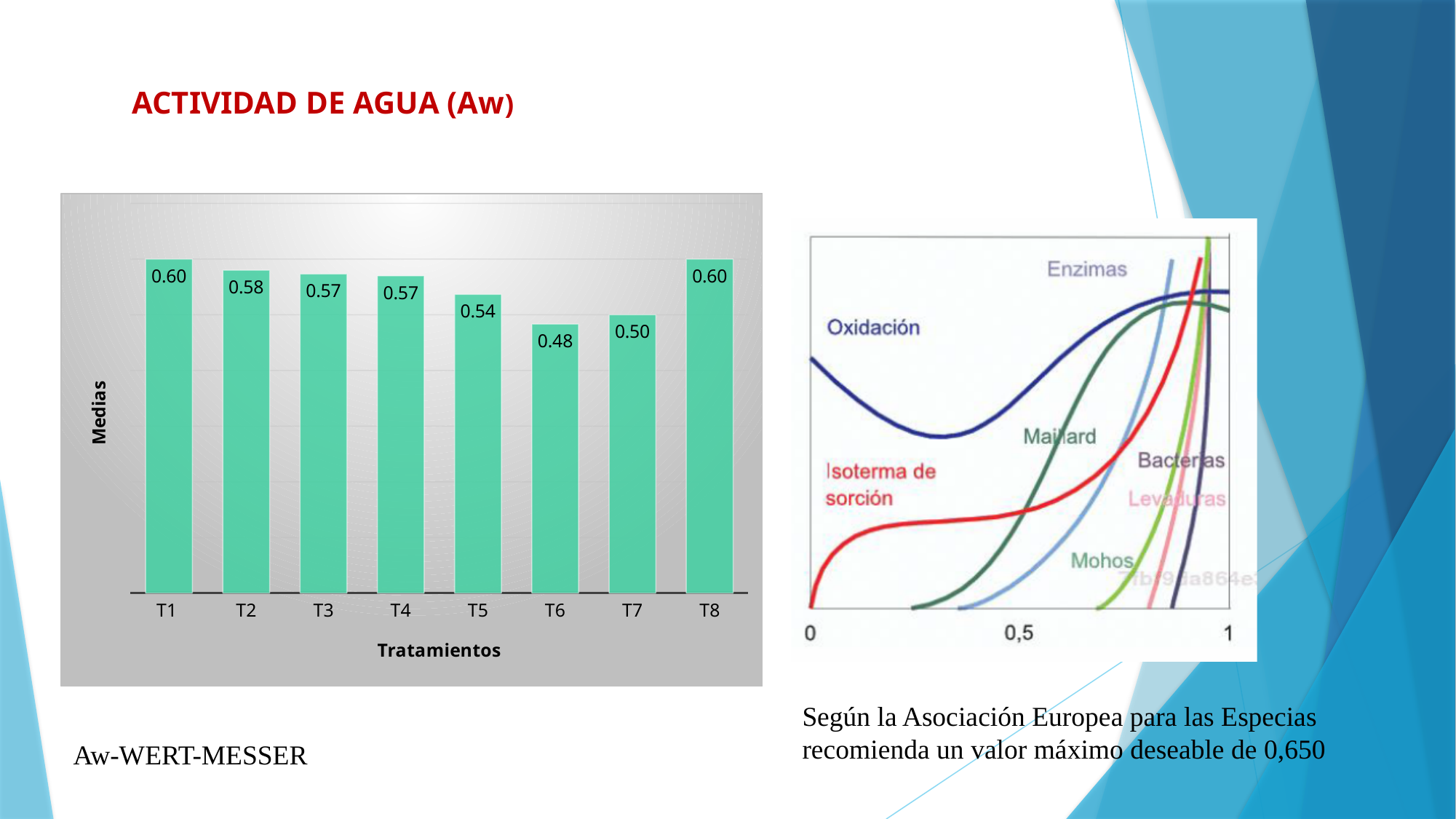
In the bar chart on the left, what is the value for T1? 0.60 What kind of chart is shown on the left of the slide? Bar chart In the bar chart on the left, what is the value for T6? 0.48 How many treatments are shown on the x axis of the bar chart on the left? 8 In the bar chart on the left, what is the difference between the values for T2 and T7? 0.08 In the bar chart on the left, which is larger, the value for T5 or the value for T7? T5 In the bar chart on the left, which is larger, the value for T2 or the value for T6? T2 In the bar chart on the left, what is the value for T5? 0.54 In the bar chart on the left, what is the difference between the values for T1 and T6? 0.12 In the bar chart on the left, what is the value for T7? 0.50 What is the x-axis title of the bar chart on the left? Tratamientos In the bar chart on the left, which treatment has the lowest value? T6